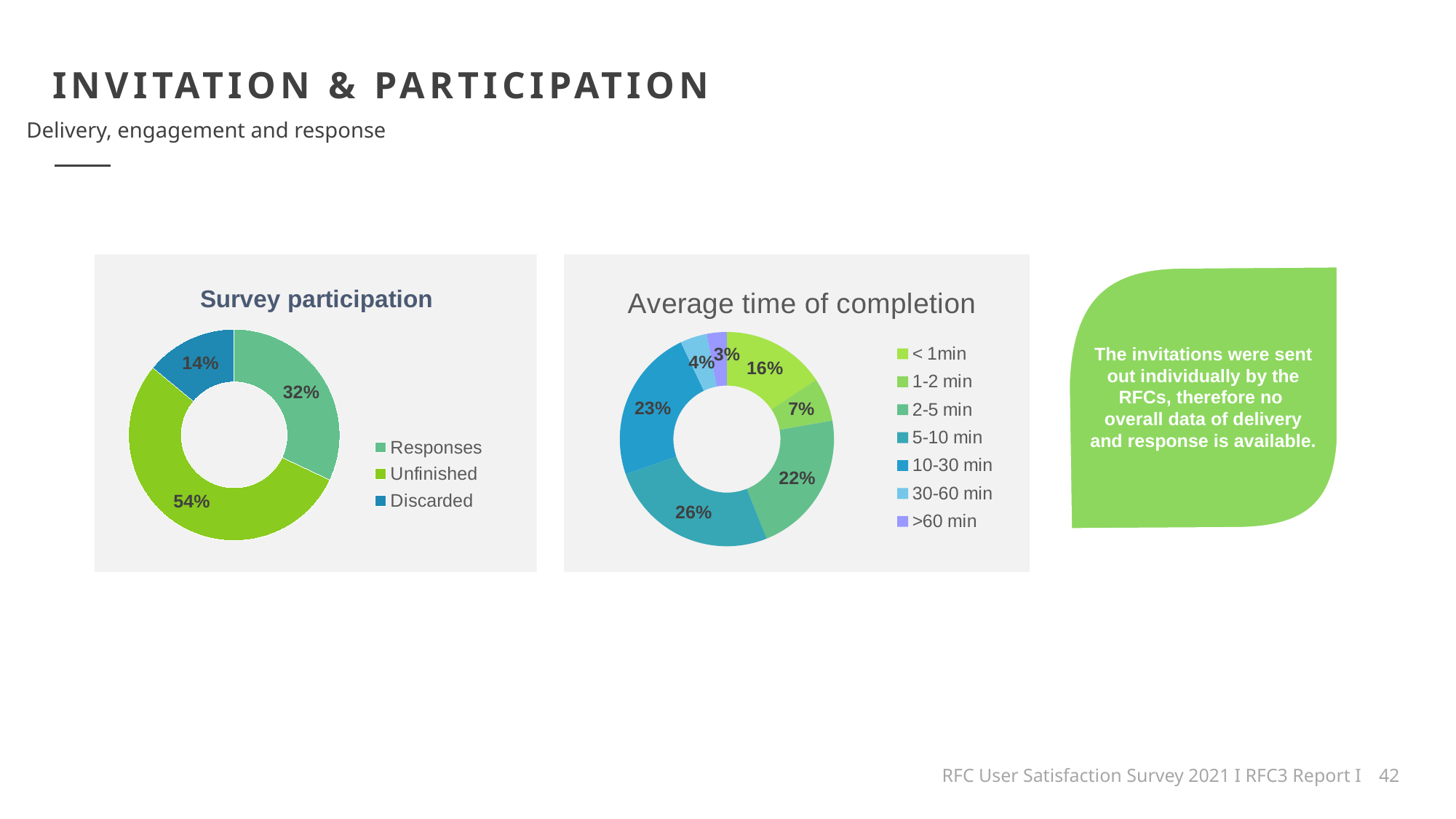
What type of chart is the 'Average time of completion' chart? Doughnut (pie) chart In the 'Average time of completion' chart, which is larger, the share for 10-30 min or the share for 2-5 min? 10-30 min In the 'Average time of completion' chart, what share is labelled for 1-2 min? 7% In the 'Survey participation' chart, how many categories does the legend list? 3 In the 'Average time of completion' chart, what share is labelled for 5-10 min? 26% In the 'Survey participation' chart, which category has the smallest share? Discarded In the 'Survey participation' chart, what share is labelled for Discarded? 14% In the 'Survey participation' chart, what is the difference in percentage points between Unfinished and Responses? 22 In the 'Average time of completion' chart, how many categories does the legend list? 7 In the 'Survey participation' chart, which category has the largest share? Unfinished In the 'Average time of completion' chart, which category has the smallest share? >60 min In the 'Survey participation' chart, what share is labelled for Unfinished? 54%